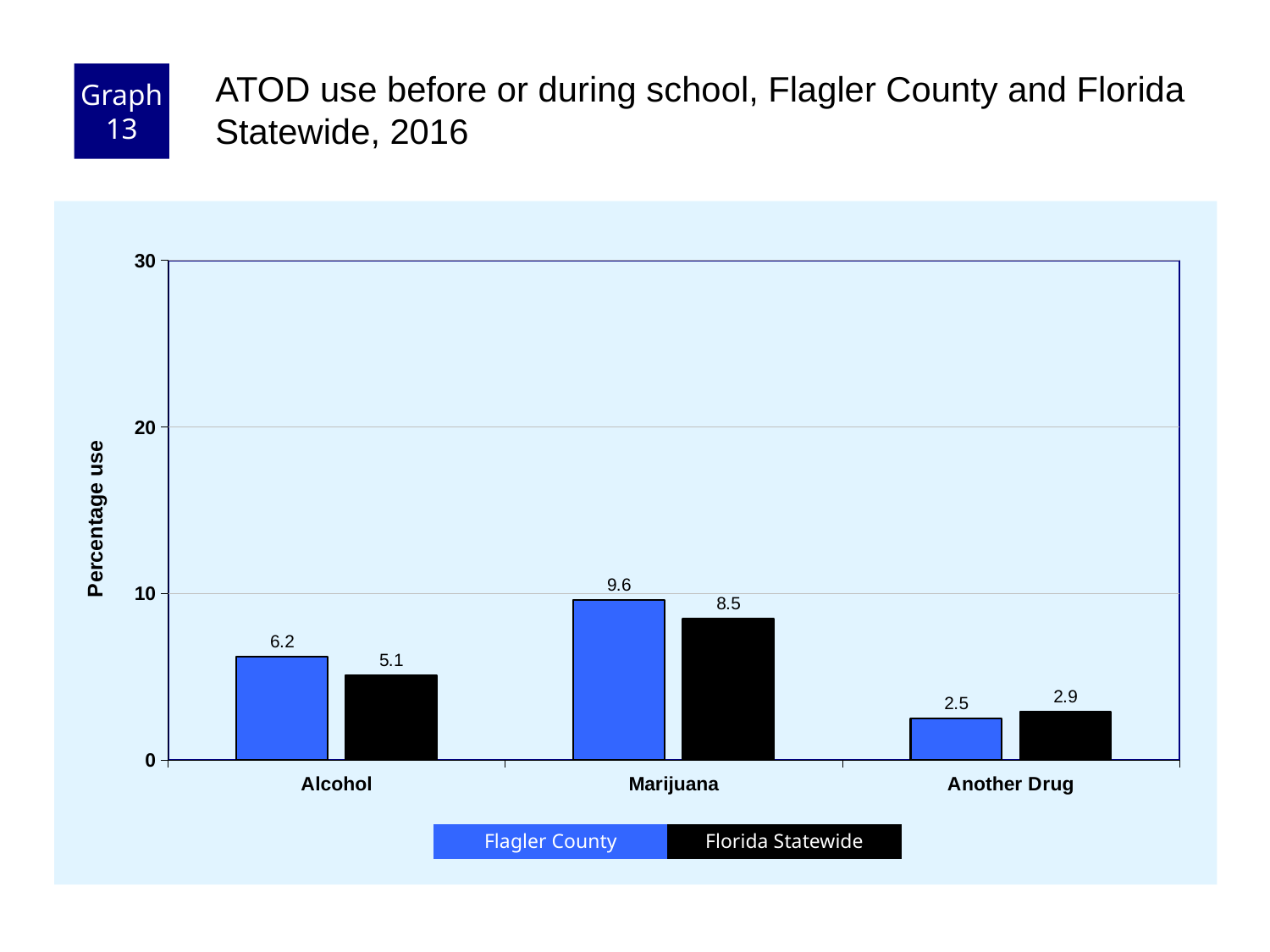
What is the difference between the Flagler County values for Alcohol and Another Drug? 3.7 How many categories are shown on the x axis? 3 Which category has the lowest Florida Statewide value? Another Drug For Another Drug, which is larger: Flagler County or Florida Statewide? Florida Statewide Which category has the highest Flagler County value? Marijuana How many series does the legend list? 2 What kind of chart is shown on the slide? bar chart What is the Flagler County value for Marijuana? 9.6 Is the Flagler County value for Marijuana greater or less than 10? less What is the Florida Statewide value for Another Drug? 2.9 What is the Florida Statewide value for Alcohol? 5.1 What is the difference between the Flagler County and Florida Statewide values for Marijuana? 1.1